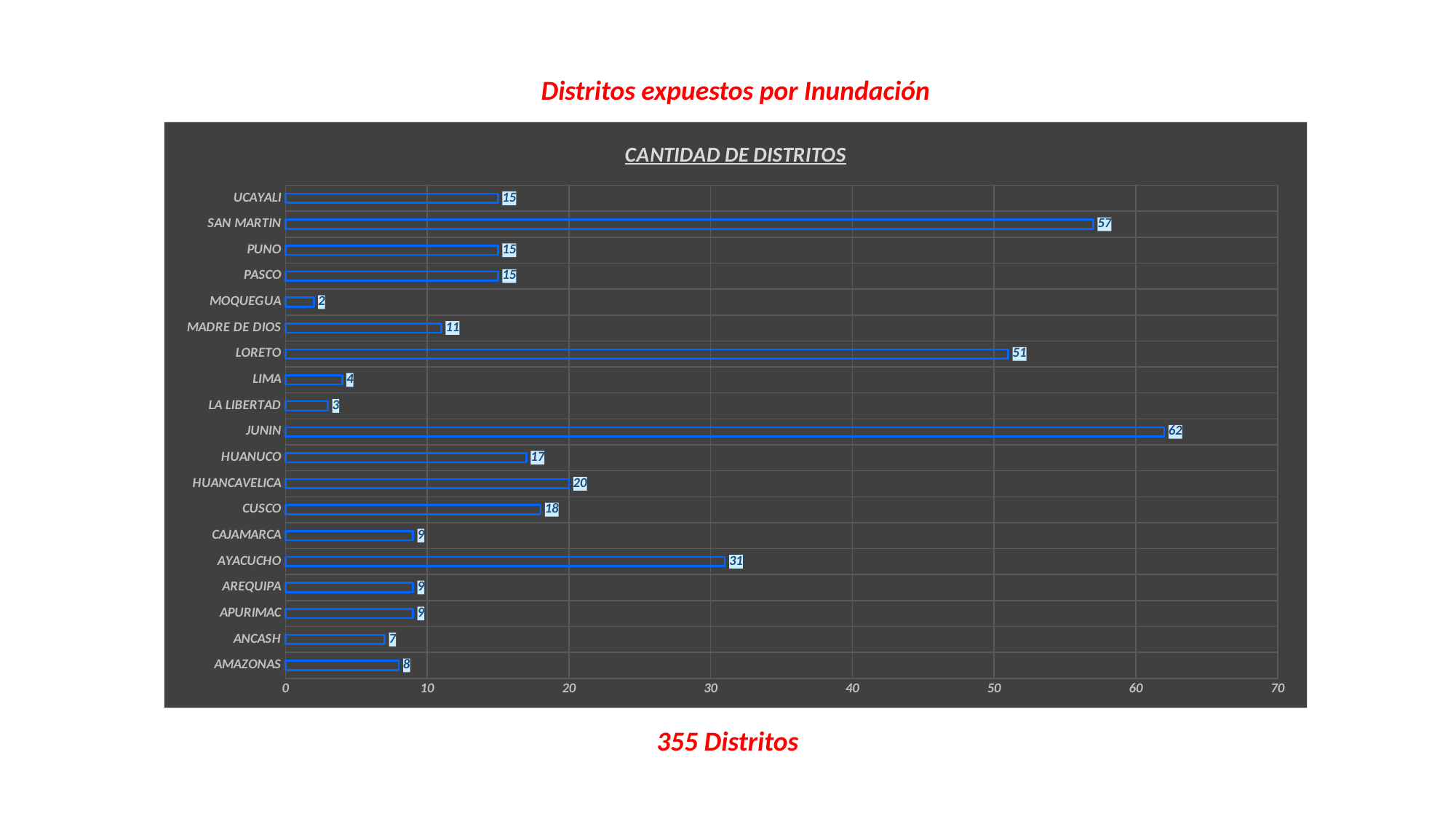
What kind of chart is shown on the slide? bar chart How many categories are shown on the chart? 19 Which category has the highest value? JUNIN What is the value for JUNIN? 62 What is the title shown inside the chart area? CANTIDAD DE DISTRITOS What is the difference between the values for HUANUCO and ANCASH? 10 Which is larger, the value for HUANCAVELICA or the value for CUSCO? HUANCAVELICA Is the value for AYACUCHO greater or less than 40? less What is the value for AYACUCHO? 31 What is the value for MADRE DE DIOS? 11 Which category has the lowest value? MOQUEGUA What is the difference between the values for SAN MARTIN and LORETO? 6